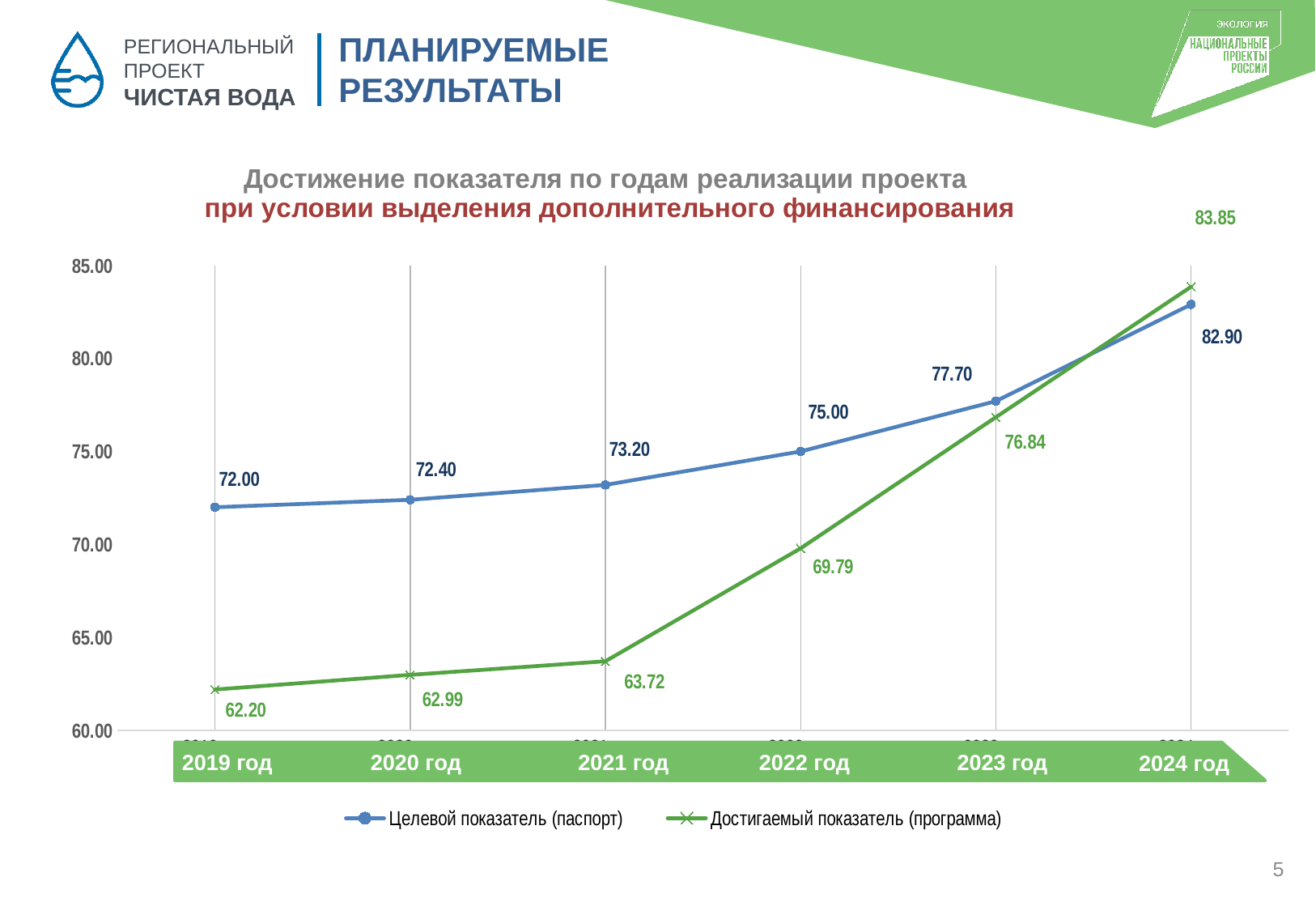
In which year is Целевой показатель (паспорт) highest? 2024 год What is the value of Достигаемый показатель (программа) for 2024 год? 83.85 What type of chart is shown on the slide? line chart Which series has the larger value in 2024 год? Достигаемый показатель (программа) What is the difference between Целевой показатель (паспорт) and Достигаемый показатель (программа) in 2021 год? 9.48 What is the value of Целевой показатель (паспорт) for 2019 год? 72.00 What is the value of Достигаемый показатель (программа) for 2022 год? 69.79 Does Достигаемый показатель (программа) rise or fall from 2019 год to 2024 год? rise How many series does the legend list? 2 How many years are plotted along the x axis? 6 What is the value of Целевой показатель (паспорт) for 2023 год? 77.70 In which year is Достигаемый показатель (программа) lowest? 2019 год